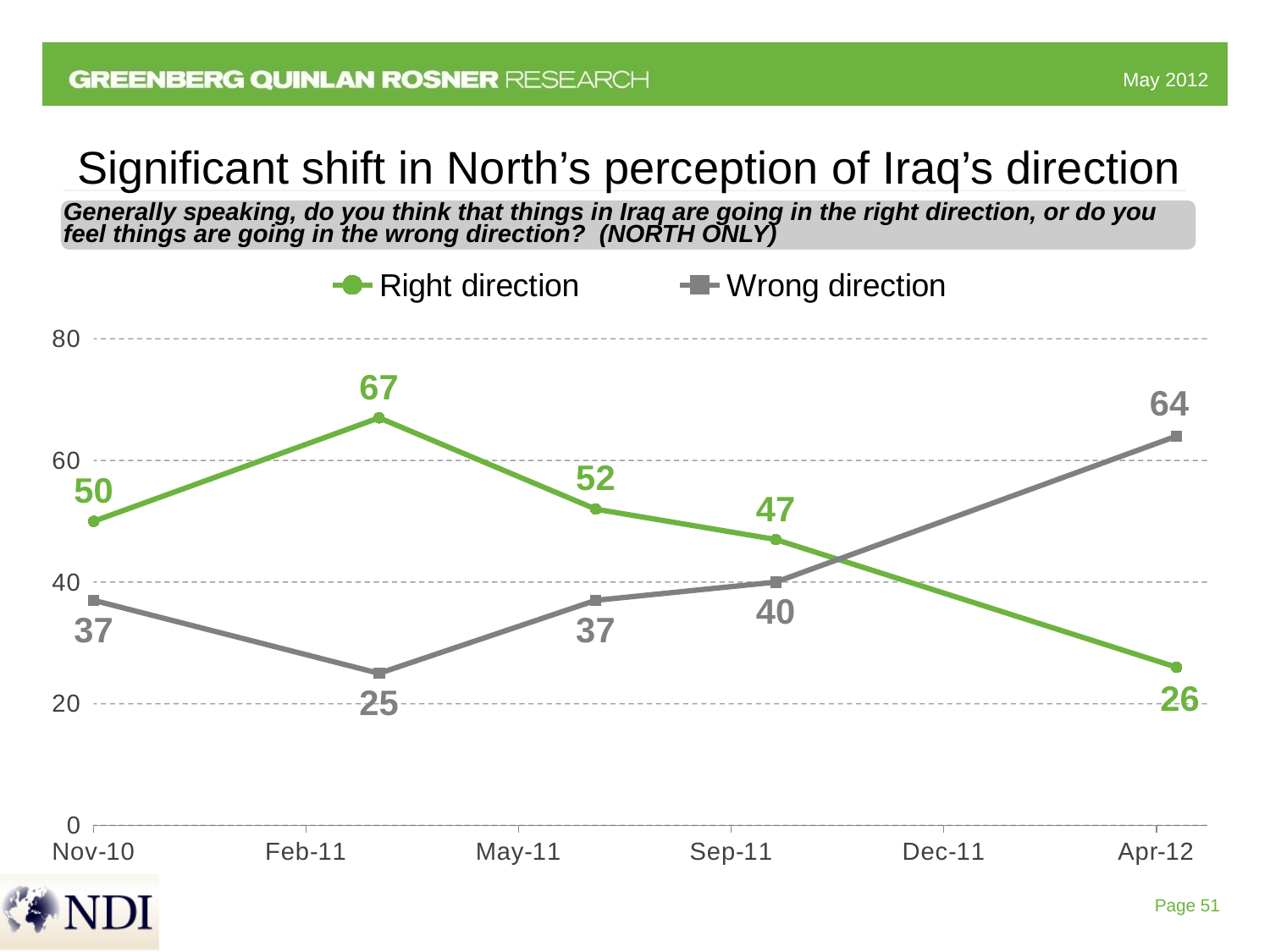
What type of chart is shown on the slide? line chart How many data points are plotted for the Right direction series? 5 What is the value for Right direction at Nov-10? 50 At Nov-10, which is larger: Right direction or Wrong direction? Right direction What colour is the Right direction line? green What is the difference between Right direction and Wrong direction at Nov-10? 13 What is the lowest value reached by the Wrong direction line? 25 What is the value for Wrong direction at Apr-12? 64 What is the difference between Wrong direction and Right direction at Apr-12? 38 Does the Wrong direction line rise or fall between Nov-10 and Apr-12 overall? rise How many series does the legend list? 2 What is the highest value reached by the Right direction line? 67